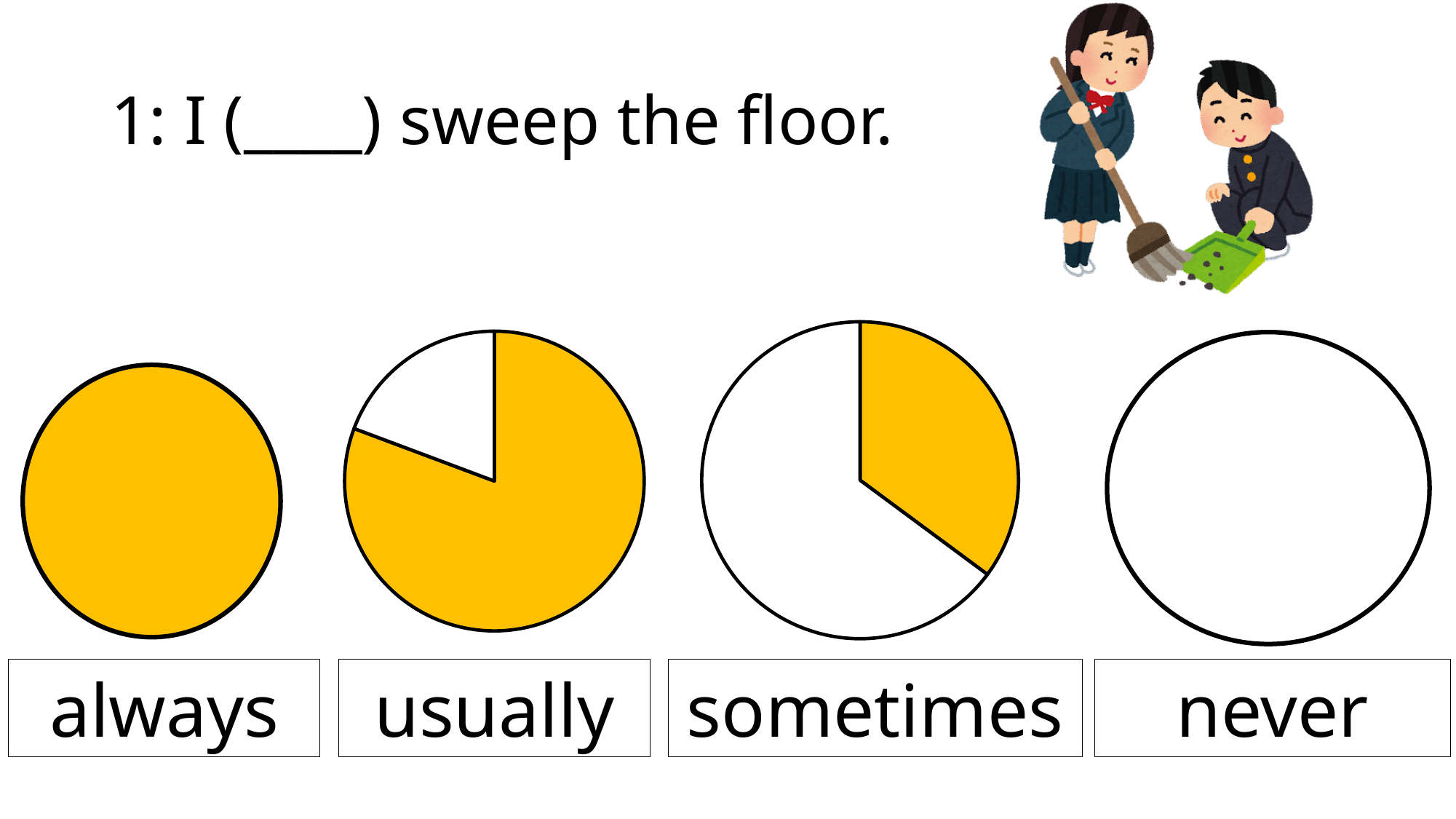
Does the filled portion of the pie charts increase or decrease from left to right across the slide? decrease How many pie charts are shown on the slide? 4 Which pie chart has the smallest filled (yellow) portion? never What colour is used for the filled portion of the pie charts? yellow Which pie chart has a larger filled portion, the one labelled 'sometimes' or the one labelled 'never'? sometimes Which pie chart has a larger filled portion, the one labelled 'always' or the one labelled 'usually'? always What is the label under the pie chart that is completely empty? never What is the label under the pie chart that is completely filled? always What is the label under the third pie chart from the left? sometimes Which pie chart has a larger filled portion, the one labelled 'usually' or the one labelled 'sometimes'? usually Which pie chart has the largest filled (yellow) portion? always What kind of chart is used to show each frequency word on the slide? pie chart